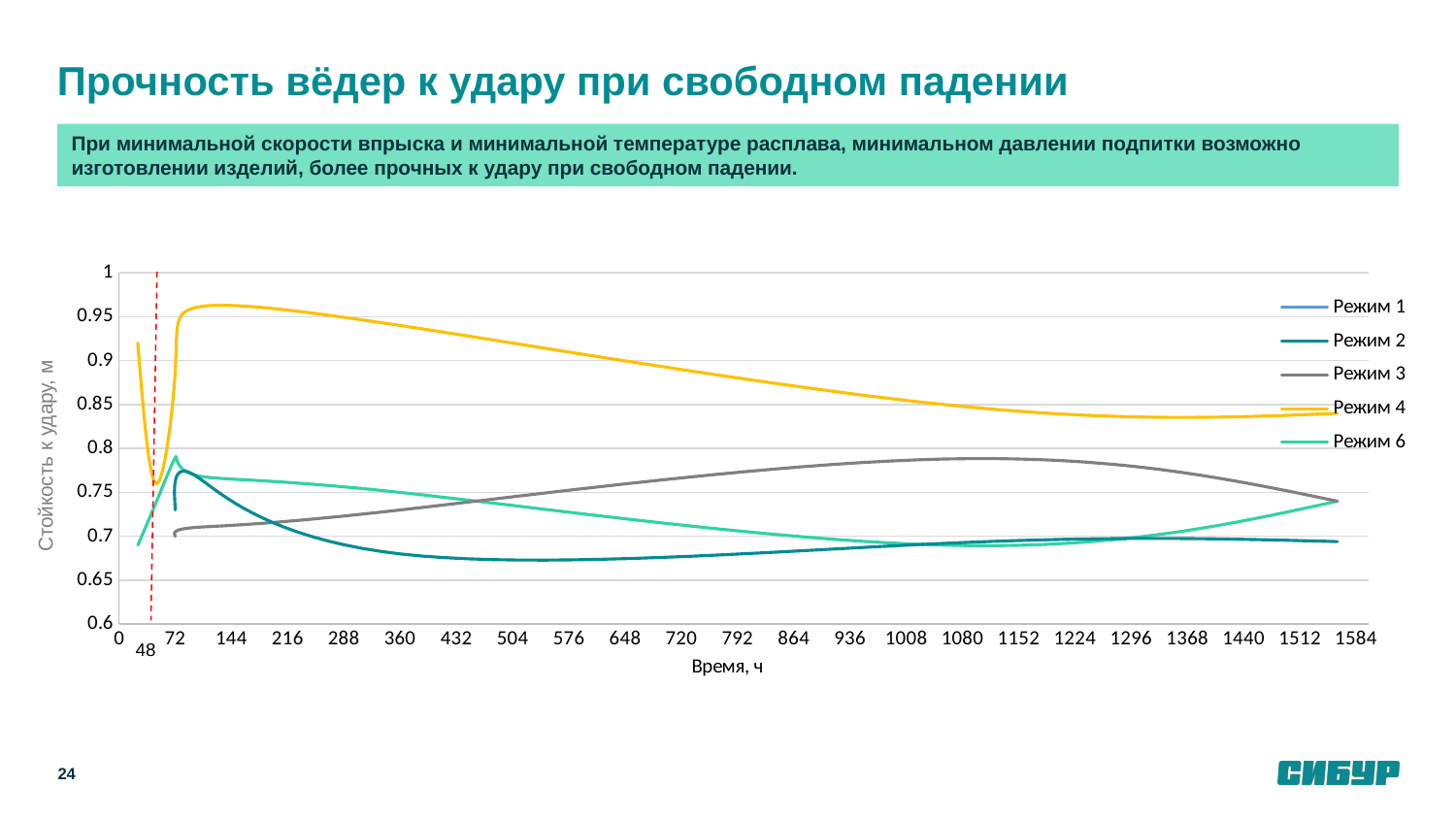
Does the value for Режим 4 rise or fall between 144 h and 1296 h? fall Is the value for Режим 2 at 504 h greater or less than 0.7? less What is the title of the chart's x axis? Время, ч Is the value for Режим 4 at 720 h greater or less than 0.85? greater Which series has the highest values across most of the time range? Режим 4 At 1080 h, which series has the larger value: Режим 3 or Режим 2? Режим 3 Is the value for Режим 3 at 1080 h greater or less than 0.75? greater How many series does the chart legend list? 5 Does the value for Режим 3 rise or fall between 72 h and 1080 h? rise Which series names are listed in the chart legend? Режим 1, Режим 2, Режим 3, Режим 4, Режим 6 What kind of chart is shown on the slide? Line chart